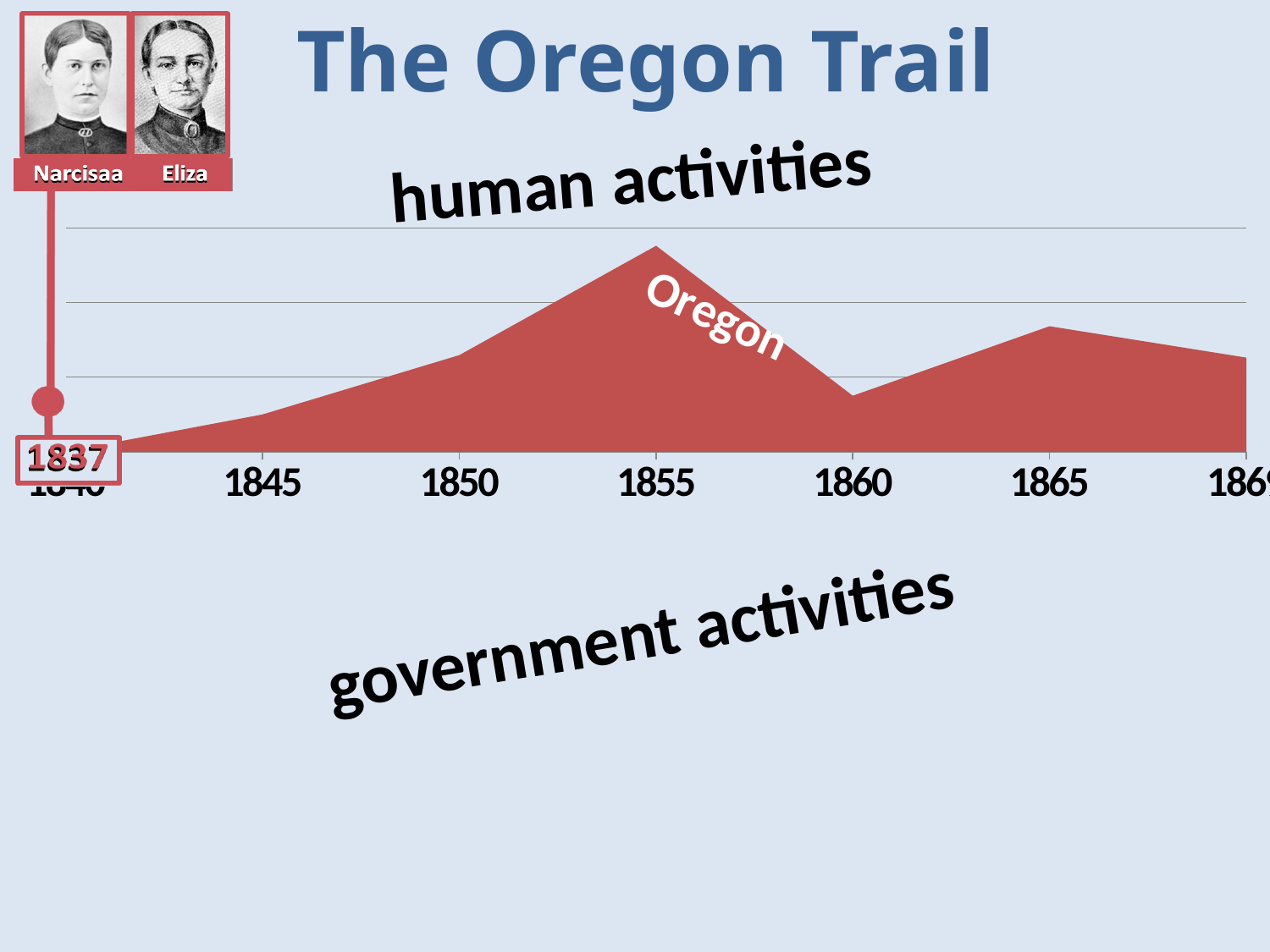
What kind of chart is shown on the slide? area chart Does the Oregon series rise or fall between 1840 and 1855? rise Which year has the larger value for the Oregon series, 1845 or 1860? 1860 Which year has the larger value for the Oregon series, 1850 or 1860? 1850 Which year has the larger value for the Oregon series, 1845 or 1865? 1865 Does the Oregon series rise or fall between 1855 and 1860? fall Does the Oregon series rise or fall between 1860 and 1865? rise What is the name of the series plotted in the area chart? Oregon What is the title of the slide containing the chart? The Oregon Trail In which year does the Oregon series reach its highest value? 1855